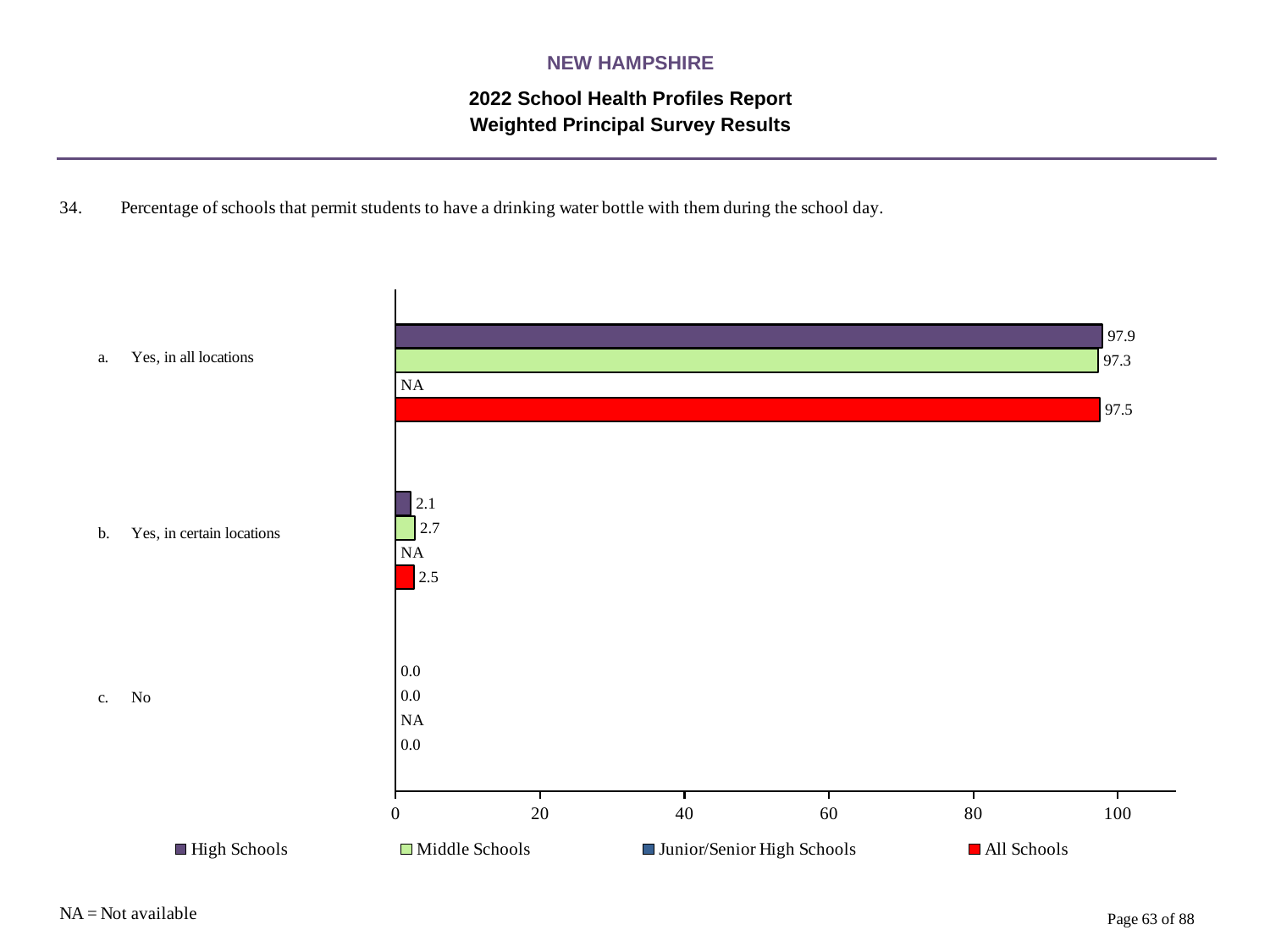
What is the difference between the High Schools and Middle Schools values for 'Yes, in all locations'? 0.6 What is the value for High Schools for 'Yes, in all locations'? 97.9 What kind of chart is shown? Bar chart Which category has the highest value for All Schools? Yes, in all locations What is the value for All Schools for 'No'? 0.0 Which is larger for 'Yes, in certain locations': the Middle Schools value or the High Schools value? Middle Schools How many series does the legend list? 4 What value is shown for Junior/Senior High Schools for 'No'? NA How many categories are shown on the chart? 3 What is the value for Middle Schools for 'Yes, in certain locations'? 2.7 Which category has the lowest value for High Schools? No What is the value for All Schools for 'Yes, in all locations'? 97.5